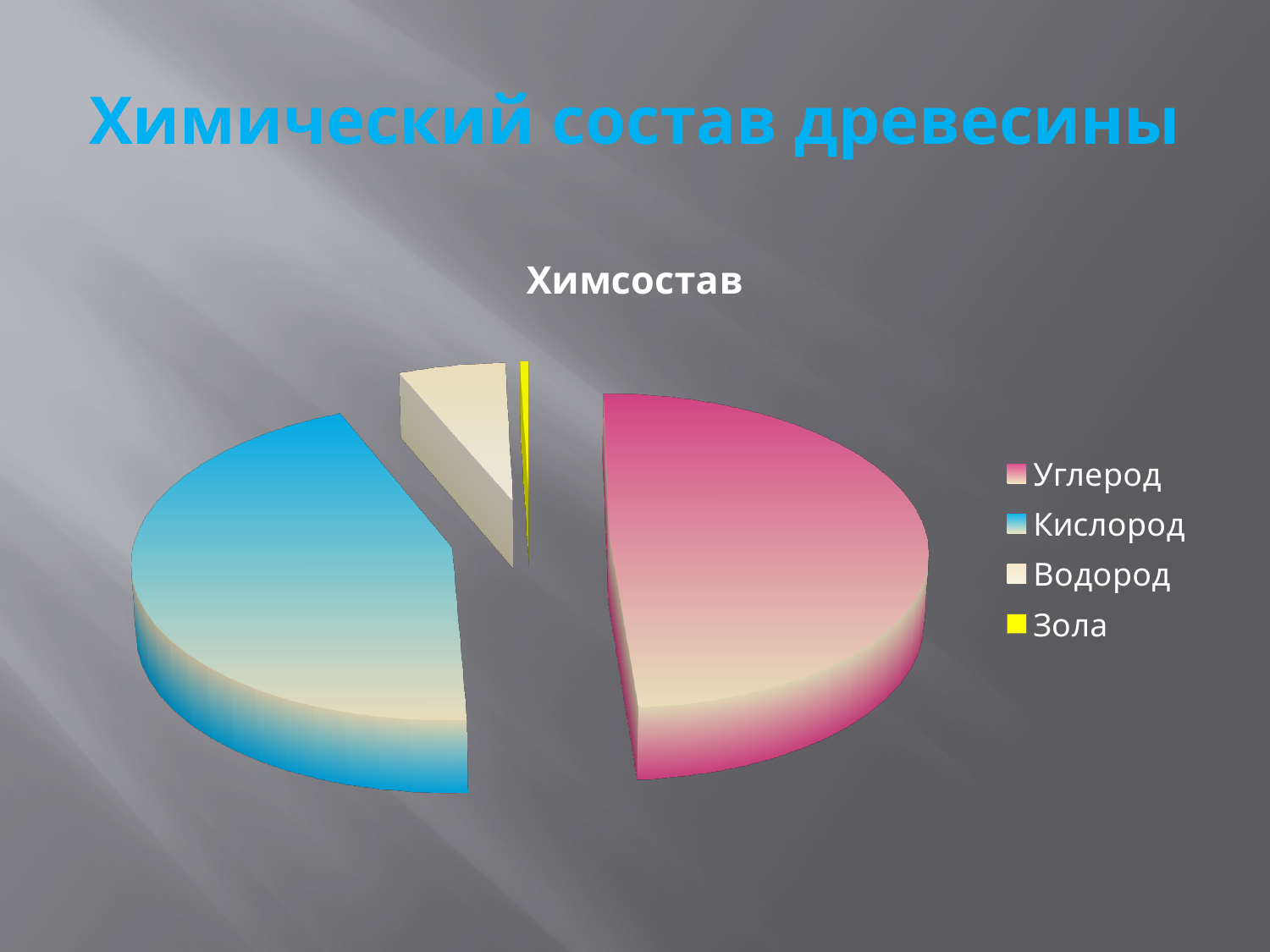
How many slices does the pie chart have? 4 Which category has the largest slice of the pie? Углерод Which slice is larger, Углерод or Зола? Углерод What kind of chart is shown on the slide? pie chart What colour is the Зола slice in the legend? yellow Which slice is larger, Кислород or Водород? Кислород Which category has the smallest slice of the pie? Зола How many entries does the legend list? 4 Which slice is larger, Водород or Зола? Водород What is the title of the chart? Химсостав